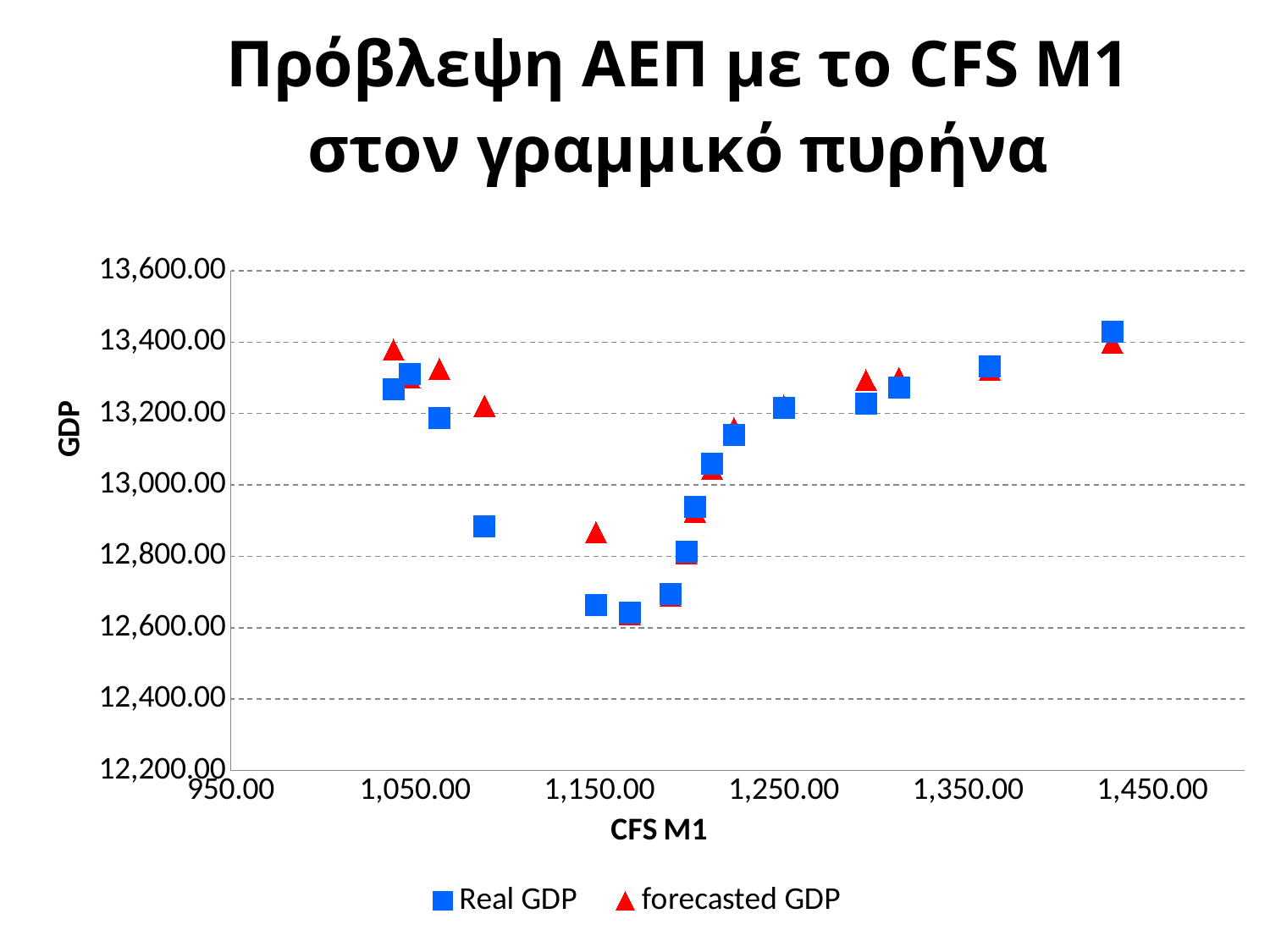
How many series does the legend list? 2 What kind of chart is shown on the slide? scatter chart Is the forecasted GDP value at the leftmost point (CFS M1 around 1,040) greater or less than 13,200.00? greater What are the two series named in the legend? Real GDP and forecasted GDP Do the Real GDP values rise or fall as CFS M1 increases from 1,050.00 to 1,150.00? fall Do the Real GDP values rise or fall as CFS M1 increases from 1,250.00 to 1,450.00? rise Is the Real GDP value at the rightmost point (CFS M1 around 1,430) greater or less than 13,200.00? greater At the leftmost point (CFS M1 around 1,040), which is higher: Real GDP or forecasted GDP? forecasted GDP What is the label of the horizontal axis? CFS M1 Is the Real GDP value at CFS M1 around 1,085 greater or less than 13,000.00? less At CFS M1 around 1,085, which is higher: Real GDP or forecasted GDP? forecasted GDP